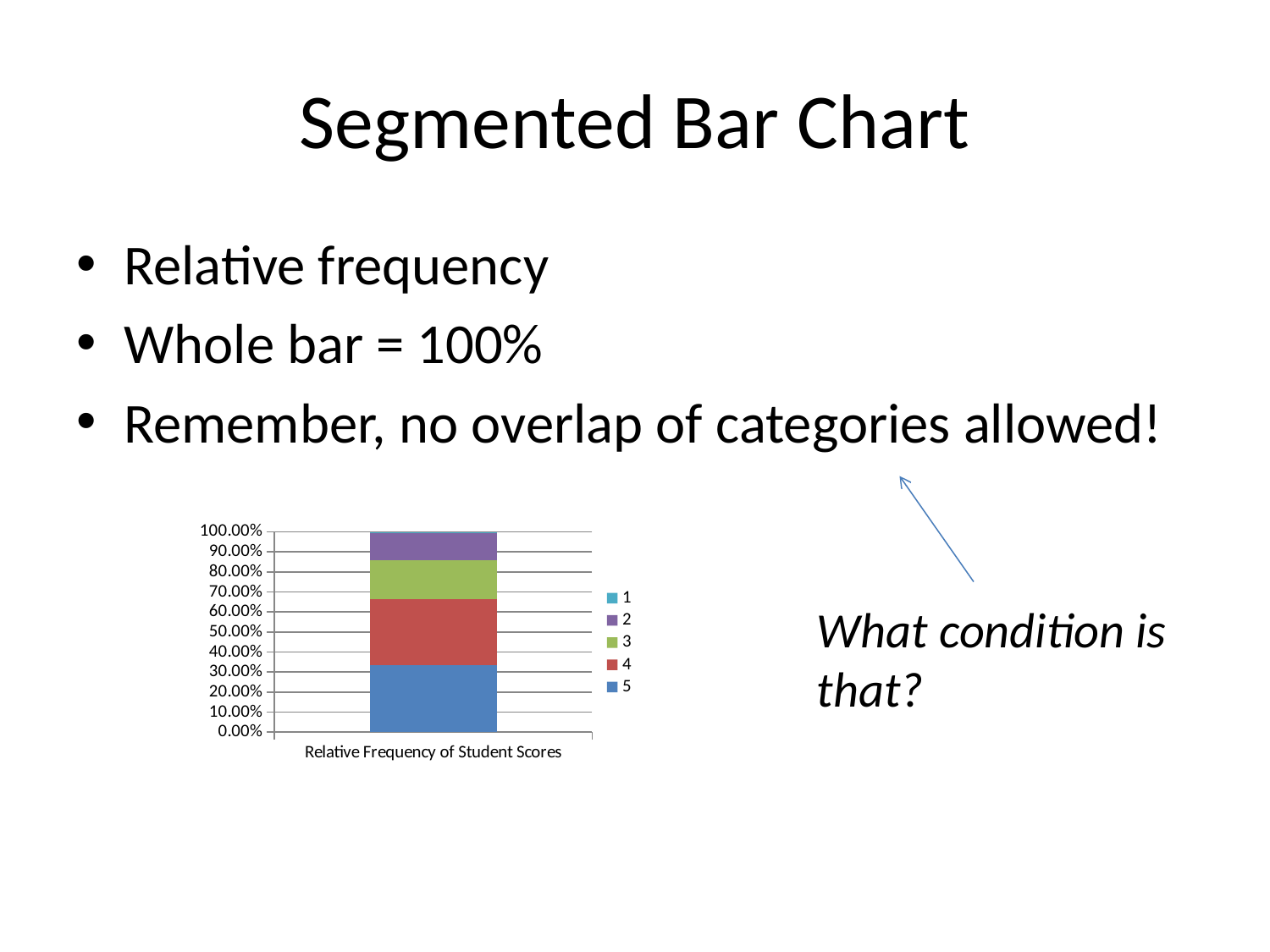
Is the segment for series 2 greater or less than 20.00%? less What kind of chart is shown on the slide? Stacked bar chart Is the segment for series 5 greater or less than 40.00%? less What colour is the segment for series 5 in the chart? Blue Which segment is larger, series 3 or series 2? 3 What is the label shown beneath the chart's x axis? Relative Frequency of Student Scores Is the segment for series 3 greater or less than 30.00%? less How many series does the chart's legend list? 5 Which segment is larger, series 5 or series 2? 5 How many bars are plotted in the chart? 1 What value does the top of the stacked bar reach on the y axis? 100.00%